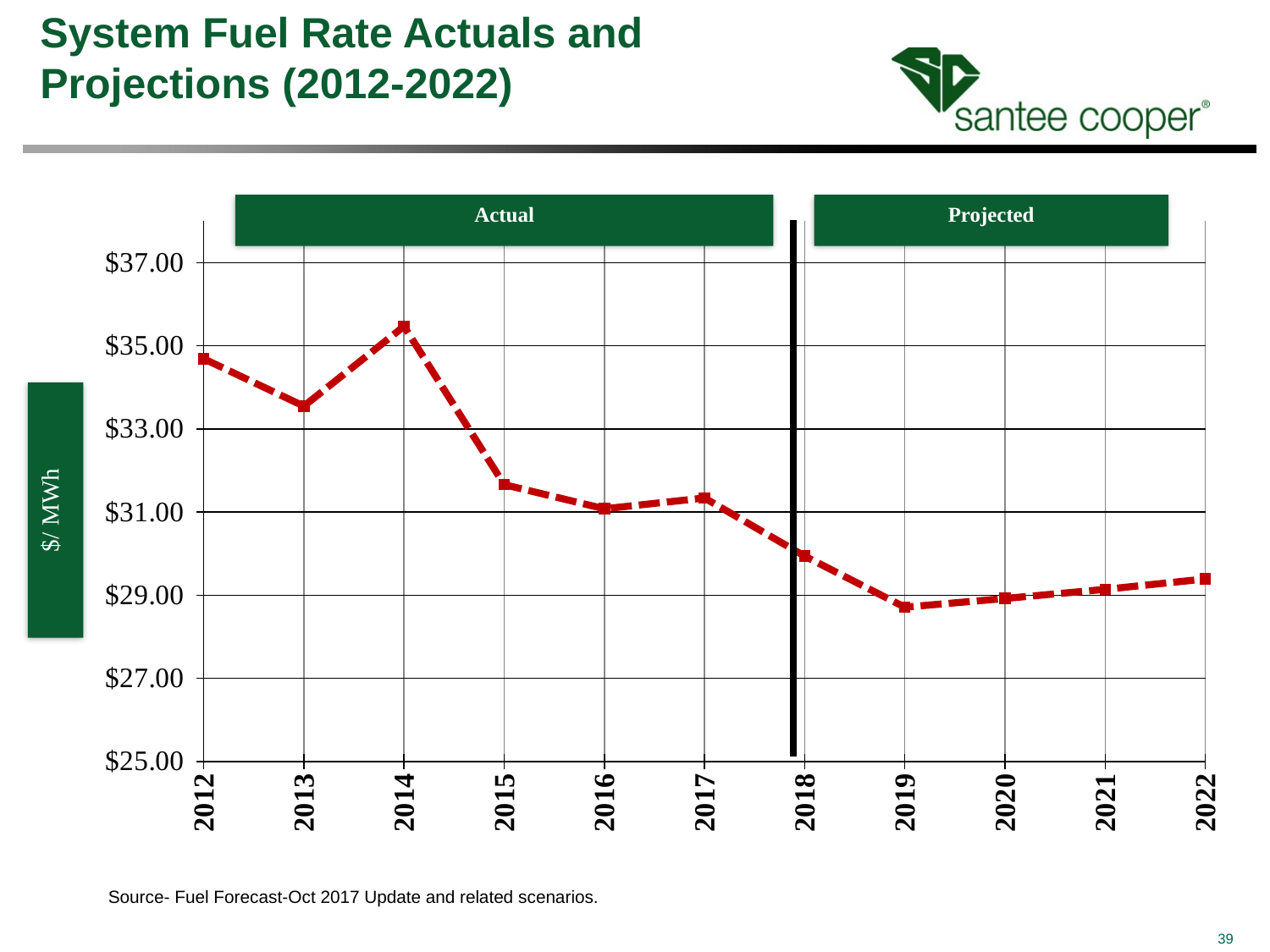
Do the values rise or fall from 2014 to 2019? fall Is the value for 2018 greater or less than $29.00? greater How many years are plotted on the x axis? 11 Is the value for 2015 greater or less than $33.00? less Which year has the highest system fuel rate? 2014 Is the value for 2014 greater or less than $35.00? greater Which is larger, the value for 2012 or the value for 2017? 2012 What is the label on the y axis? $/ MWh What kind of chart is shown on the slide? line chart What are the two section labels shown above the chart? Actual and Projected